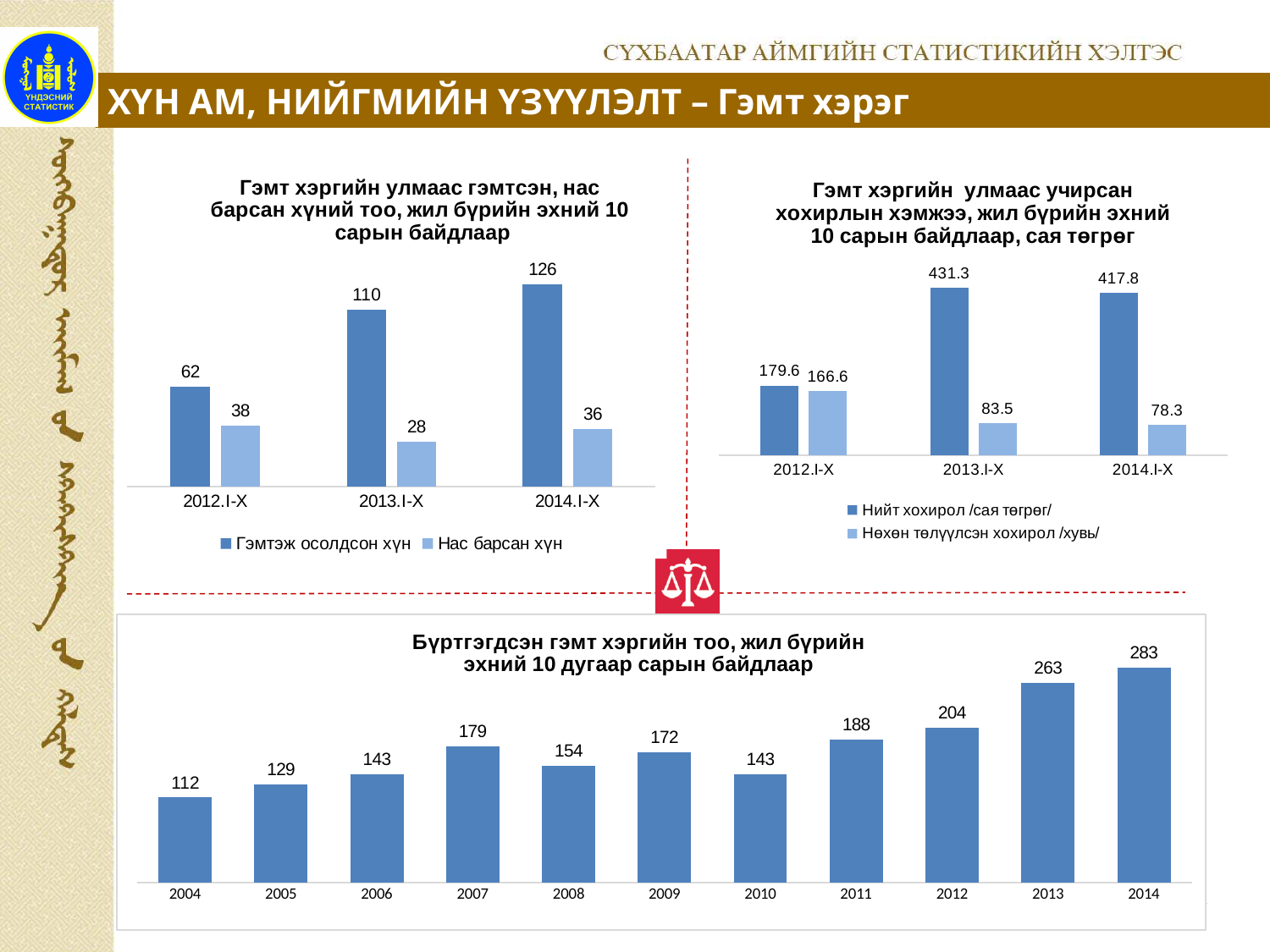
In the top-right chart (Гэмт хэргийн улмаас учирсан хохирлын хэмжээ), what is the value for Нийт хохирол /сая төгрөг/ in 2013.I-X? 431.3 In the bottom chart (Бүртгэгдсэн гэмт хэргийн тоо), which year has the lowest value? 2004 In the top-left chart (Гэмт хэргийн улмаас гэмтсэн, нас барсан хүний тоо), what is the value for Нас барсан хүн in 2014.I-X? 36 In the top-right chart (Гэмт хэргийн улмаас учирсан хохирлын хэмжээ), what is the difference between Нийт хохирол and Нөхөн төлүүлсэн хохирол in 2014.I-X? 339.5 In the bottom chart (Бүртгэгдсэн гэмт хэргийн тоо), is the value for 2007 larger or smaller than the value for 2008? larger In the top-left chart (Гэмт хэргийн улмаас гэмтсэн, нас барсан хүний тоо), what is the value for Гэмтэж осолдсон хүн in 2013.I-X? 110 In the bottom chart (Бүртгэгдсэн гэмт хэргийн тоо), what is the value for 2012? 204 In the top-left chart (Гэмт хэргийн улмаас гэмтсэн, нас барсан хүний тоо), how many series does the legend list? 2 In the bottom chart (Бүртгэгдсэн гэмт хэргийн тоо), what is the difference between the values for 2014 and 2013? 20 In the bottom chart (Бүртгэгдсэн гэмт хэргийн тоо), which year has the highest value? 2014 What kind of chart is the top-right chart (Гэмт хэргийн улмаас учирсан хохирлын хэмжээ)? bar chart In the bottom chart (Бүртгэгдсэн гэмт хэргийн тоо), how many years are shown on the x axis? 11